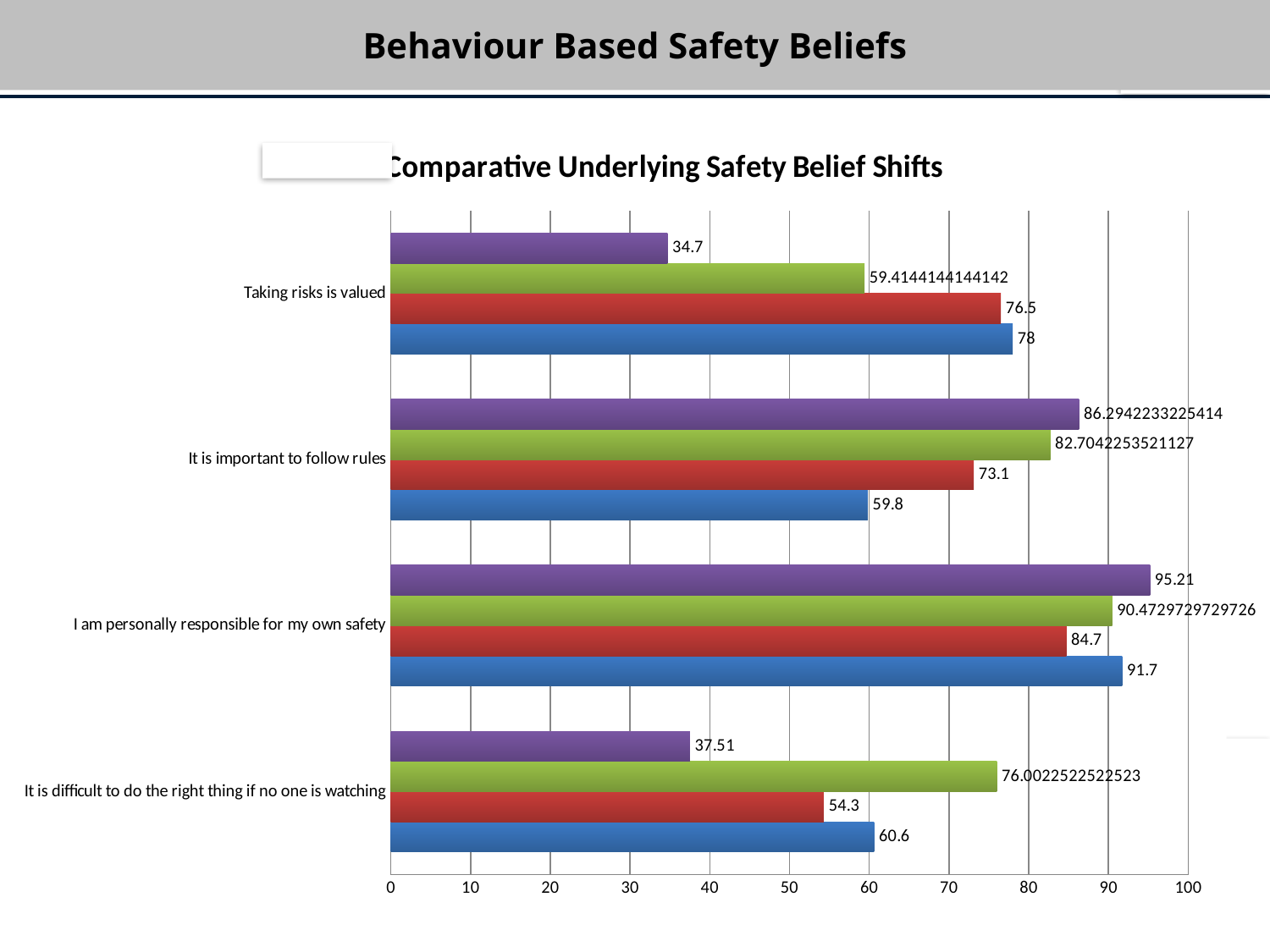
Which category has the lowest purple bar value? Taking risks is valued What kind of chart is shown on the slide? bar chart Is the value of the red bar for 'It is difficult to do the right thing if no one is watching' greater or less than 60? less What is the value of the purple bar for 'I am personally responsible for my own safety'? 95.21 What is the value of the blue bar for 'Taking risks is valued'? 78 What is the difference between the blue bar (91.7) and the red bar (84.7) for 'I am personally responsible for my own safety'? 7 Which category has the highest purple bar value? I am personally responsible for my own safety What is the value of the purple bar for 'It is difficult to do the right thing if no one is watching'? 37.51 What is the title of the chart? Comparative Underlying Safety Belief Shifts What is the value of the red bar for 'It is important to follow rules'? 73.1 For 'It is important to follow rules', which is larger: the purple bar or the blue bar? purple bar How many categories (belief statements) are shown on the chart? 4